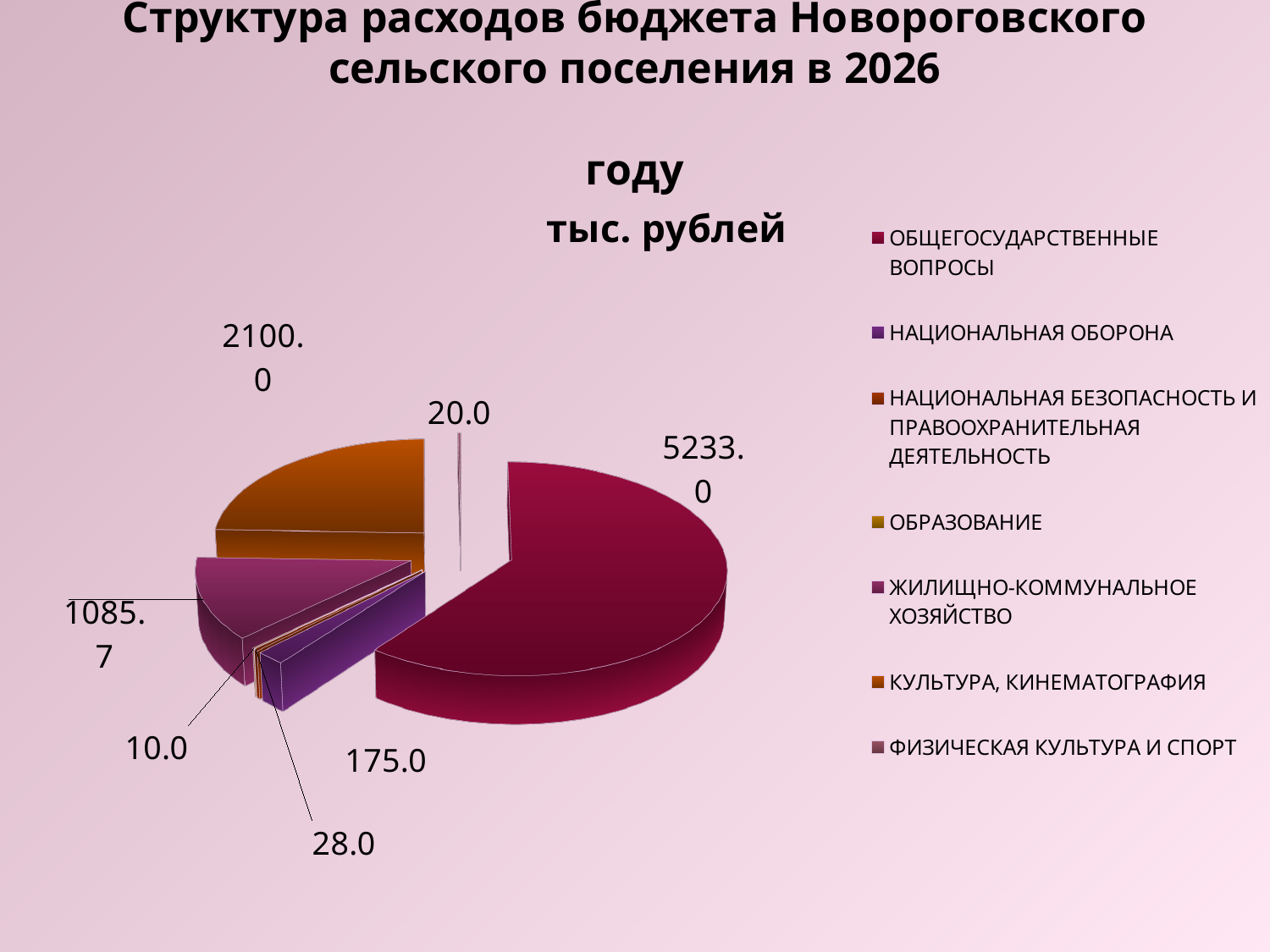
What unit is stated in the chart's subtitle? тыс. рублей How many categories does the legend of the pie chart list? 7 Which category has the largest slice of the pie? ОБЩЕГОСУДАРСТВЕННЫЕ ВОПРОСЫ What is the value for КУЛЬТУРА, КИНЕМАТОГРАФИЯ? 2100.0 What is the difference between the values for ОБЩЕГОСУДАРСТВЕННЫЕ ВОПРОСЫ and КУЛЬТУРА, КИНЕМАТОГРАФИЯ? 3133.0 Which is larger, the value for ЖИЛИЩНО-КОММУНАЛЬНОЕ ХОЗЯЙСТВО or the value for НАЦИОНАЛЬНАЯ ОБОРОНА? ЖИЛИЩНО-КОММУНАЛЬНОЕ ХОЗЯЙСТВО What is the difference between the values for КУЛЬТУРА, КИНЕМАТОГРАФИЯ and ЖИЛИЩНО-КОММУНАЛЬНОЕ ХОЗЯЙСТВО? 1014.3 What is the value for ФИЗИЧЕСКАЯ КУЛЬТУРА И СПОРТ? 20.0 What type of chart is shown on the slide? Pie chart What is the value for НАЦИОНАЛЬНАЯ ОБОРОНА? 175.0 What is the value for ЖИЛИЩНО-КОММУНАЛЬНОЕ ХОЗЯЙСТВО? 1085.7 What is the value for ОБЩЕГОСУДАРСТВЕННЫЕ ВОПРОСЫ? 5233.0